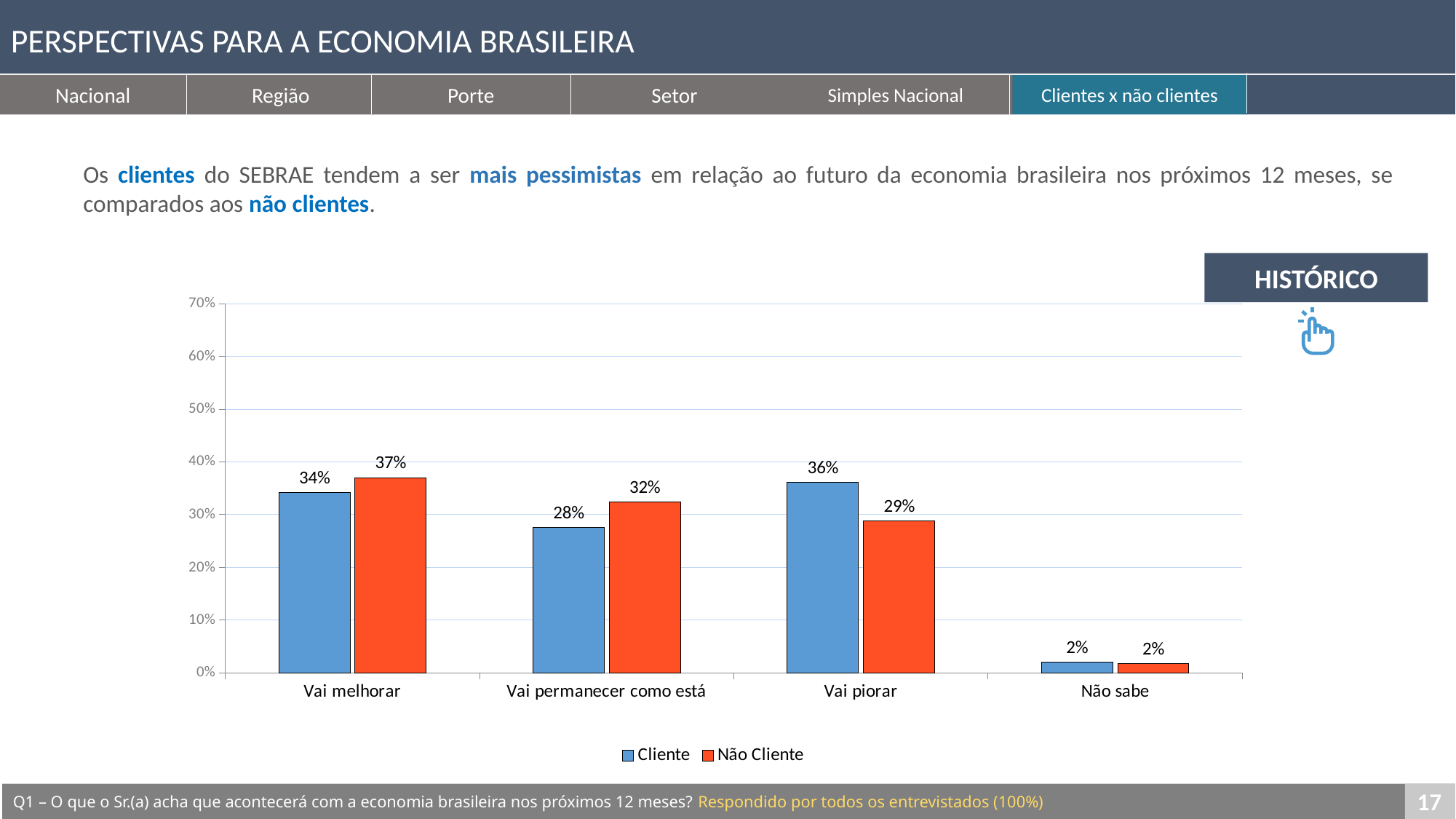
What kind of chart is shown on the slide? bar chart What is the value for Cliente in the "Vai piorar" category? 36% Which category has the lowest value for the Não Cliente series? Não sabe Is the value for Cliente in "Vai permanecer como está" greater or less than 30%? less In the "Vai melhorar" category, which series has the larger value, Cliente or Não Cliente? Não Cliente What is the difference between Não Cliente and Cliente in the "Vai piorar" category? 7% What is the value for Cliente in the "Vai melhorar" category? 34% Which category has the highest value for the Cliente series? Vai piorar What colour are the bars for the Não Cliente series? red What is the value for Não Cliente in the "Vai permanecer como está" category? 32% How many series does the legend list? 2 How many categories are shown on the x axis? 4